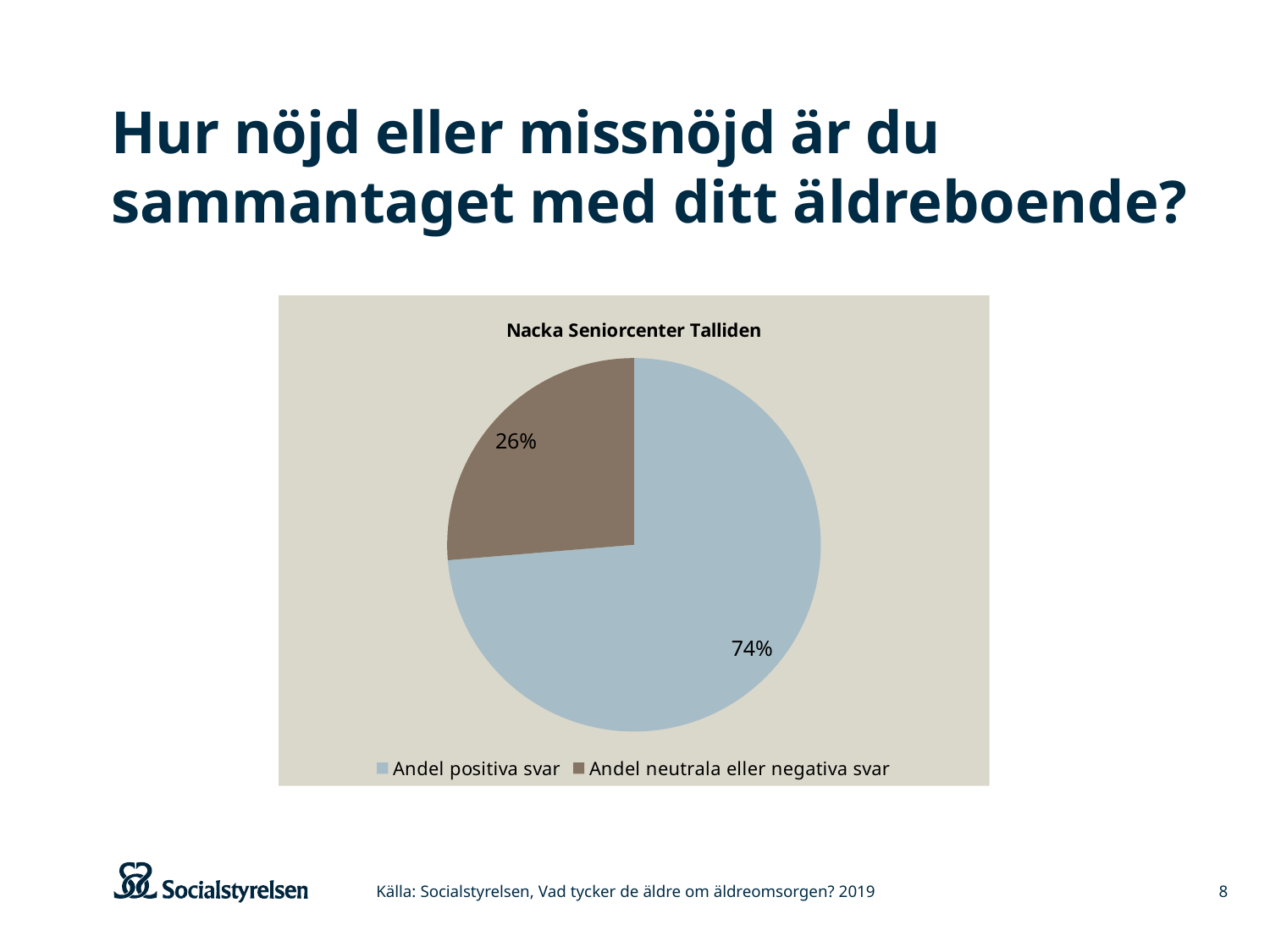
What share of the pie is 'Andel positiva svar'? 74% What is the difference in percentage points between 'Andel positiva svar' and 'Andel neutrala eller negativa svar'? 48 Which slice is the smallest? Andel neutrala eller negativa svar What share of the pie is 'Andel neutrala eller negativa svar'? 26% Which legend entry is shown in brown? Andel neutrala eller negativa svar What kind of chart is shown on the slide? pie chart How many entries does the legend list? 2 What is the chart's title? Nacka Seniorcenter Talliden Which is larger, 'Andel positiva svar' or 'Andel neutrala eller negativa svar'? Andel positiva svar How many slices does the pie chart have? 2 Which slice is the largest? Andel positiva svar